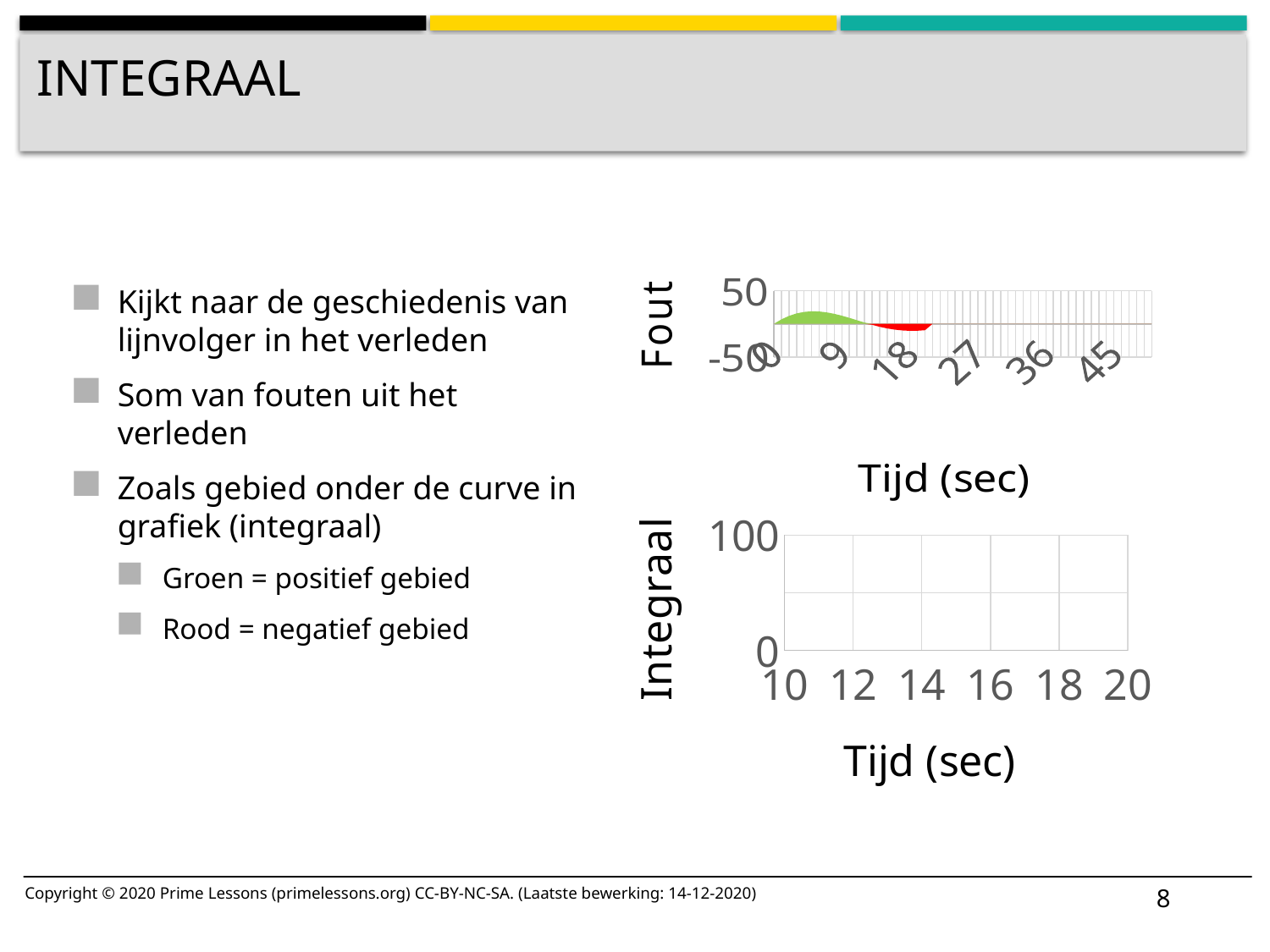
What is the lowest value shown on the vertical axis of the top chart (Fout)? -50 What is the horizontal axis label of the bottom chart (Integraal)? Tijd (sec) What is the highest value shown on the vertical axis of the bottom chart (Integraal)? 100 What is the highest value shown on the vertical axis of the top chart (Fout)? 50 In the top chart (Fout), is the value at time 9 greater or less than 0? greater In the top chart (Fout), what colour is the area where the error is positive? Green How many tick labels are shown on the horizontal axis of the top chart (Fout)? 6 In the top chart (Fout), is the value at time 18 greater or less than 0? less How many tick labels are shown on the horizontal axis of the bottom chart (Integraal)? 6